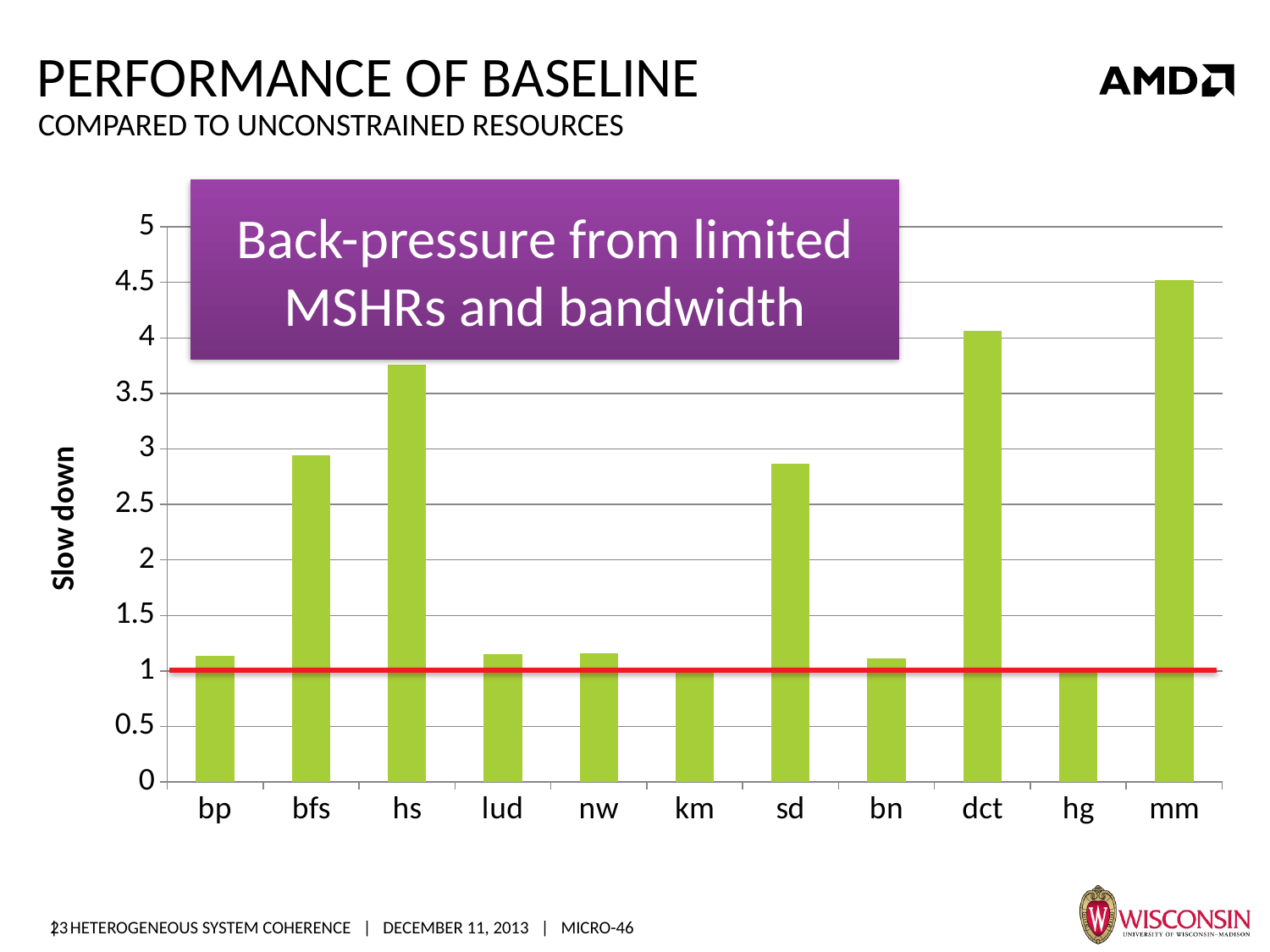
Is the value for bfs greater or less than 3? less At what y-axis value is the red horizontal line drawn? 1 What kind of chart is shown on the slide? bar chart What is the label of the y axis? Slow down How many categories are plotted along the x axis? 11 Which category has the highest slow down? mm Which has a larger slow down, hs or bfs? hs Is the value for mm greater or less than 4? greater Which has a larger slow down, mm or dct? mm Is the value for hs greater or less than 3.5? greater